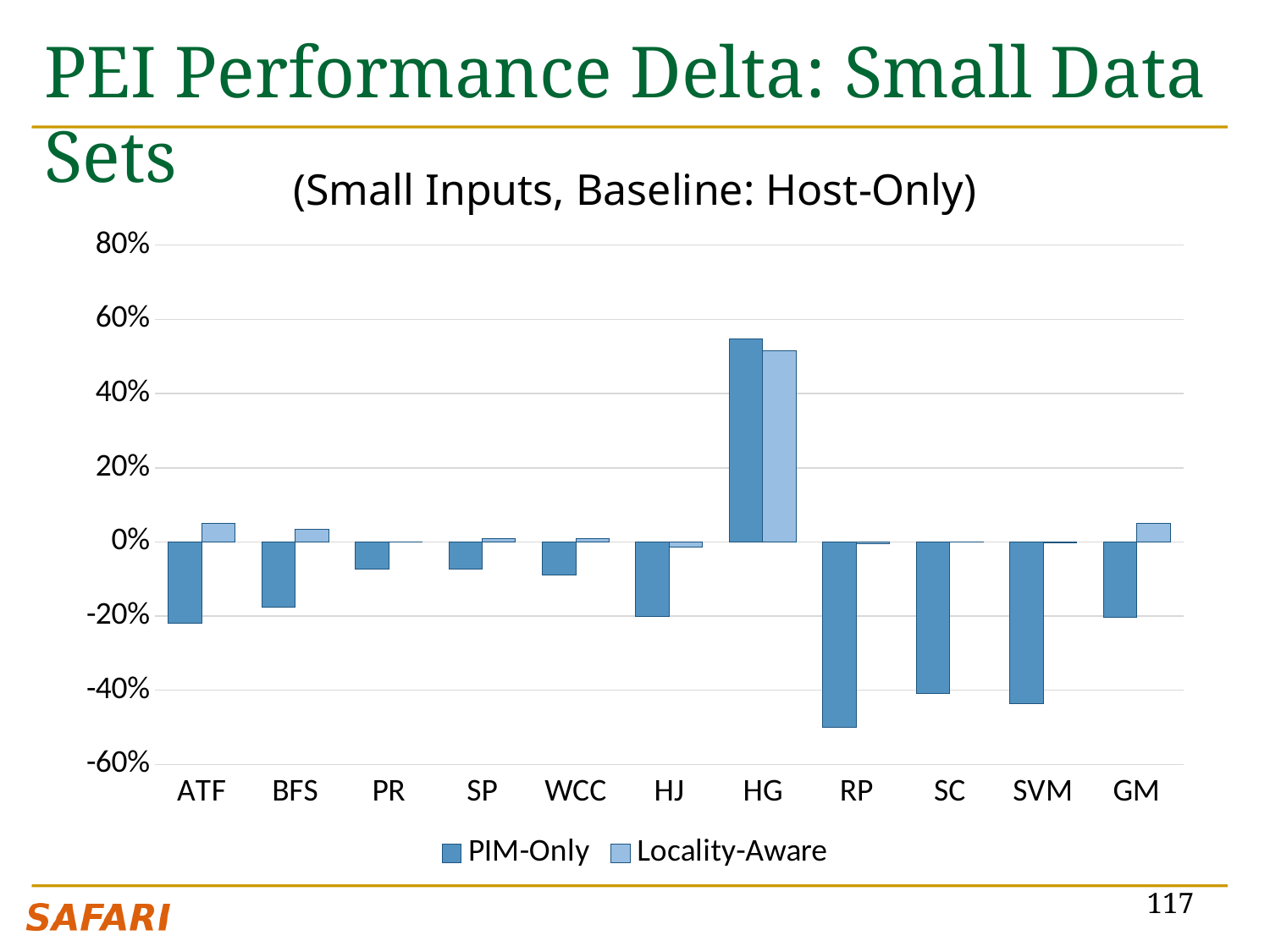
Is the PIM-Only value for RP greater or less than -40%? less Which category has the highest Locality-Aware value? HG Is the PIM-Only value for HG greater or less than 40%? greater How many categories are shown along the x axis? 11 How many series does the legend list? 2 Which is larger, the PIM-Only value for RP or the PIM-Only value for SC? SC What kind of chart is shown on the slide? bar chart Which is larger, the Locality-Aware value for ATF or the Locality-Aware value for HJ? ATF Is the PIM-Only value for SC greater or less than -20%? less Which category has the lowest PIM-Only value? RP What are the two series named in the legend? PIM-Only and Locality-Aware Which category has the highest PIM-Only value? HG